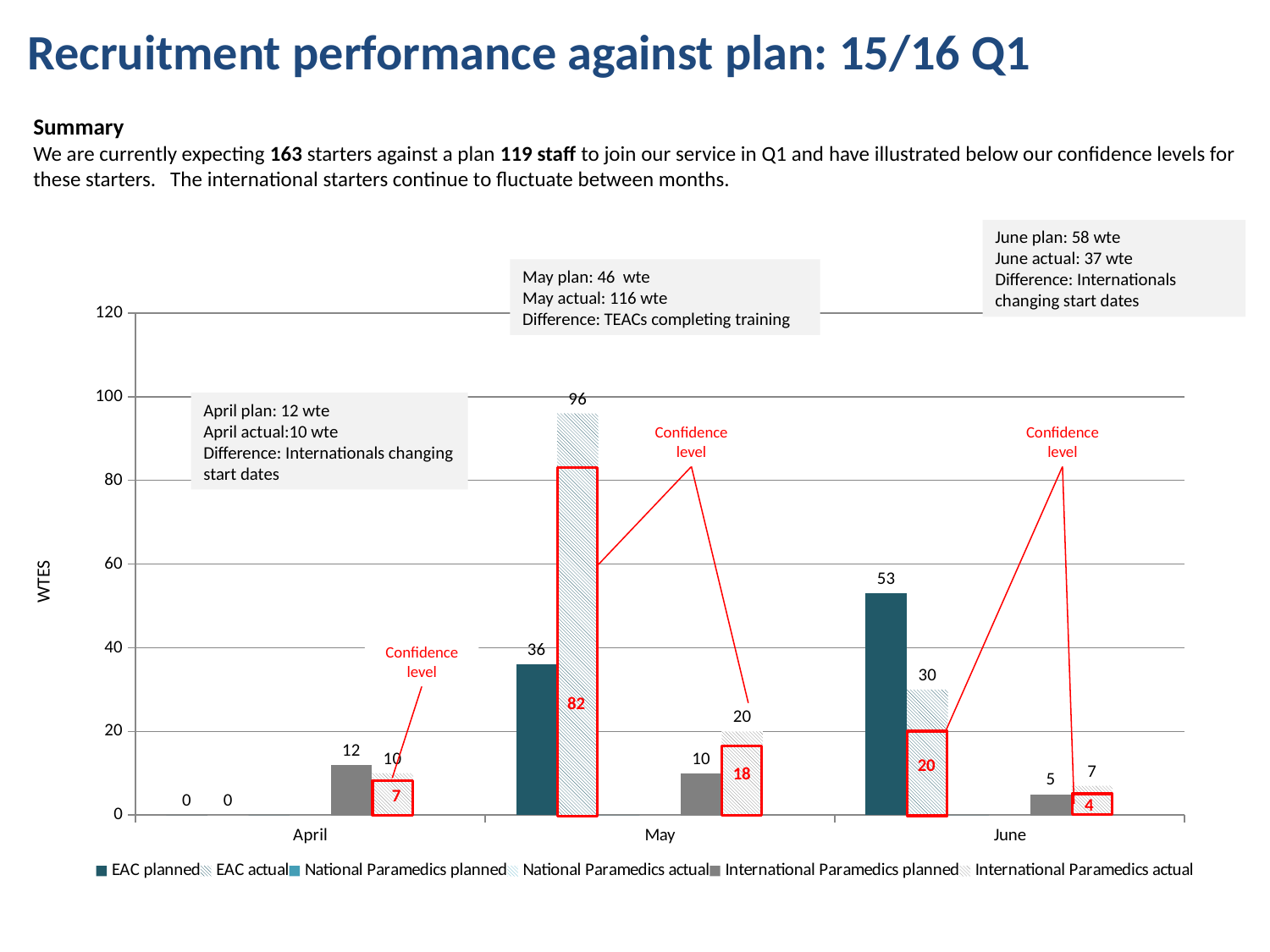
Is the EAC actual value for May greater or less than 80? greater How many series does the chart legend list? 6 In May, which is larger: EAC planned or EAC actual? EAC actual What is the title of the chart's vertical axis? WTES In which month is the EAC actual value highest? May What kind of chart is shown on the slide? bar chart What is the International Paramedics actual value for June? 7 What is the EAC planned value for June? 53 How many months are shown on the x axis of the chart? 3 What is the International Paramedics planned value for April? 12 What is the difference between EAC planned and EAC actual in June? 23 What is the EAC actual value for May? 96